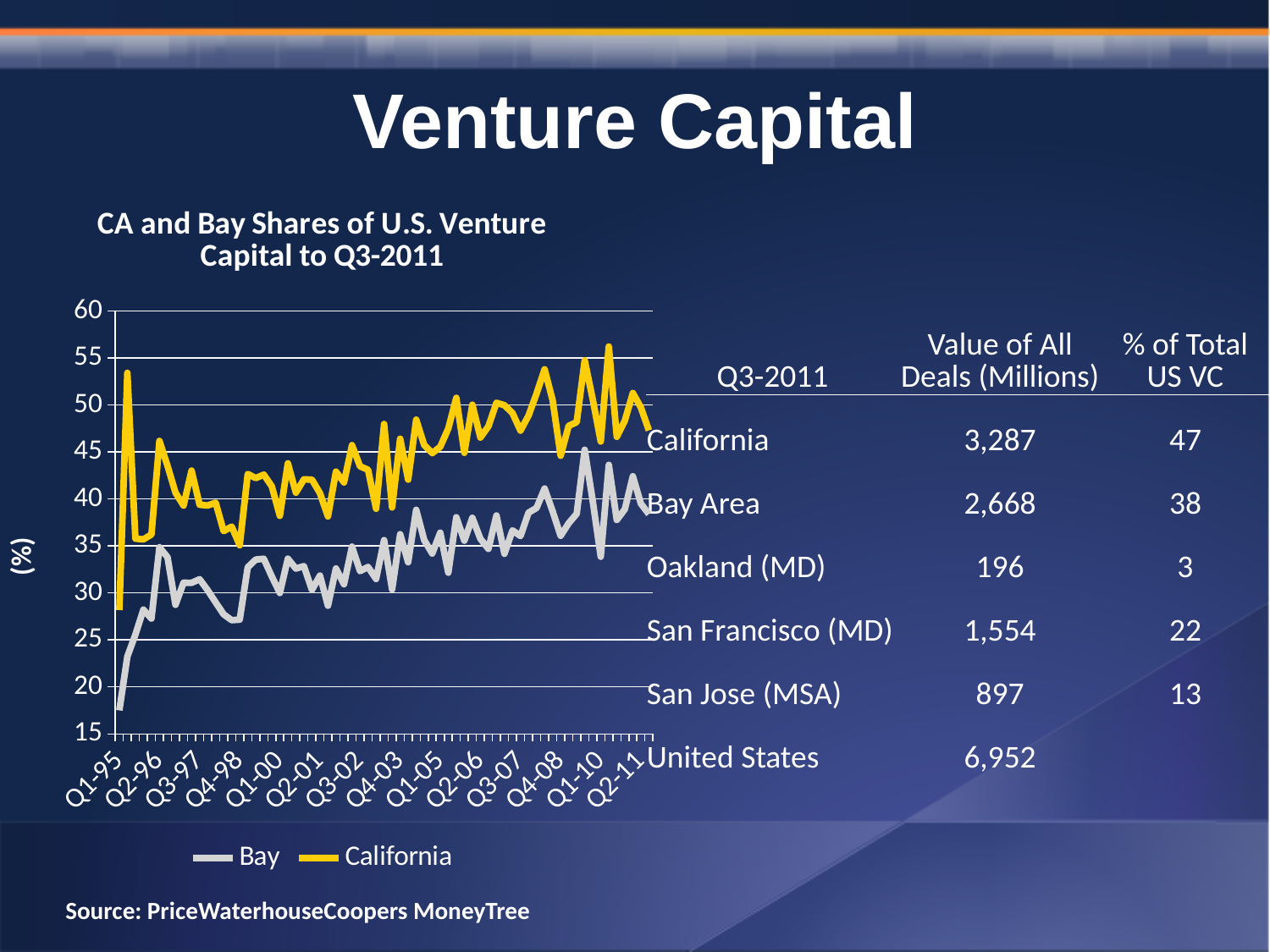
Which series is drawn in yellow in the chart? California Does the Bay series generally rise or fall from Q1-95 to Q2-11? rise Is the value for California at Q2-95 greater or less than 50? greater What kind of chart is shown on the slide? line chart How many series does the chart's legend list? 2 Which series is lower at Q1-95, Bay or California? Bay Is the value for California at Q1-10 greater or less than 50? less What is the title of the chart? CA and Bay Shares of U.S. Venture Capital to Q3-2011 Is the value for Bay at Q4-98 greater or less than 30? less Which series has the higher values across the chart, Bay or California? California